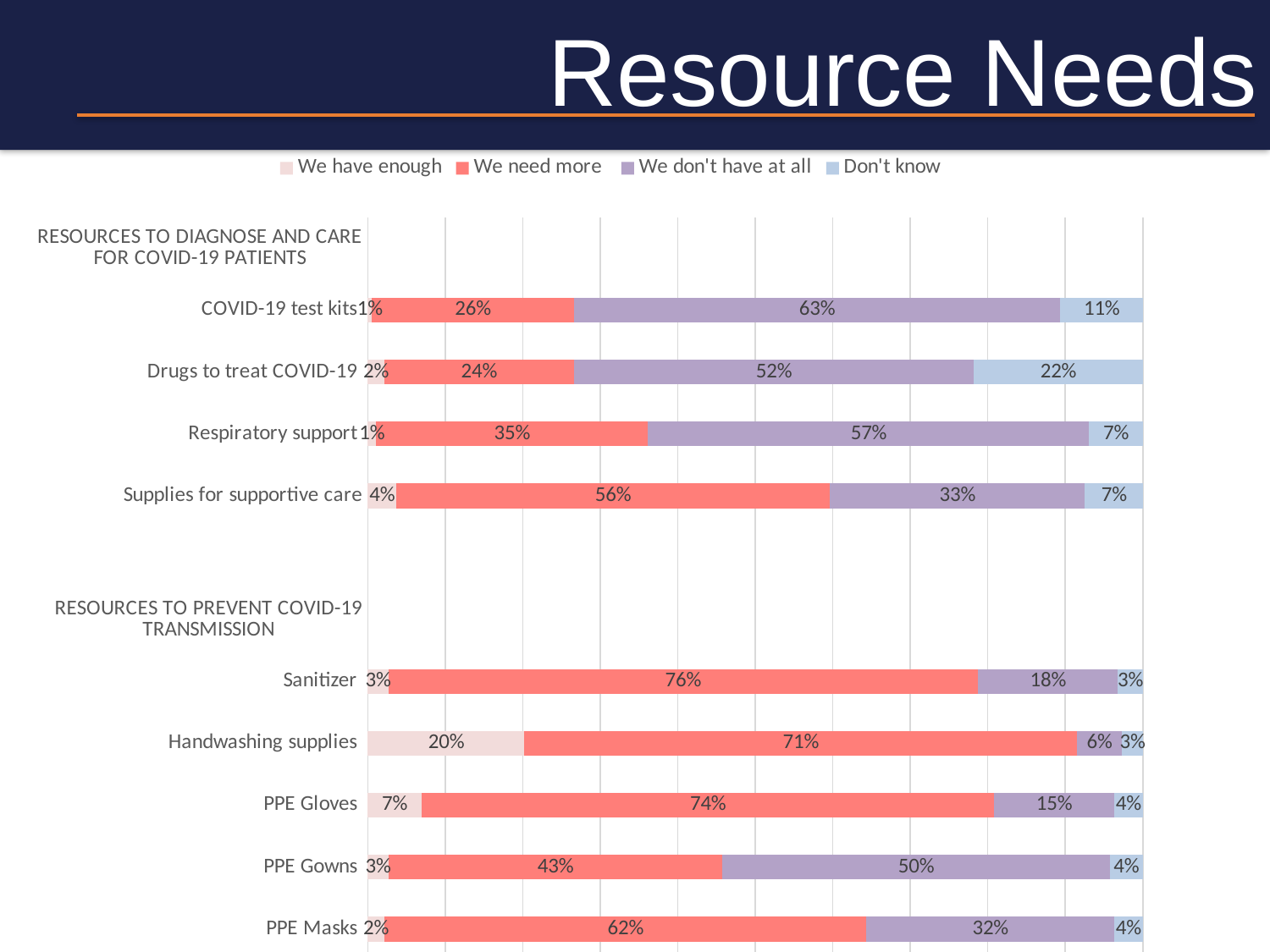
What is the "We have enough" value for Handwashing supplies? 20% What is the "Don't know" value for Drugs to treat COVID-19? 22% What kind of chart is shown on the slide? Stacked bar chart Which category has the lowest "We don't have at all" value? Handwashing supplies How many resource categories (bars) are plotted in the chart? 9 How many series does the legend list? 4 What is the title of the slide? Resource Needs Which is larger: the "We need more" value for PPE Gloves or for PPE Masks? PPE Gloves Which category has the highest "We need more" value? Sanitizer What percentage of respondents said "We don't have at all" for COVID-19 test kits? 63% What is the "We need more" value for Sanitizer? 76% What is the difference between the "We don't have at all" values for Respiratory support and PPE Gowns? 7%